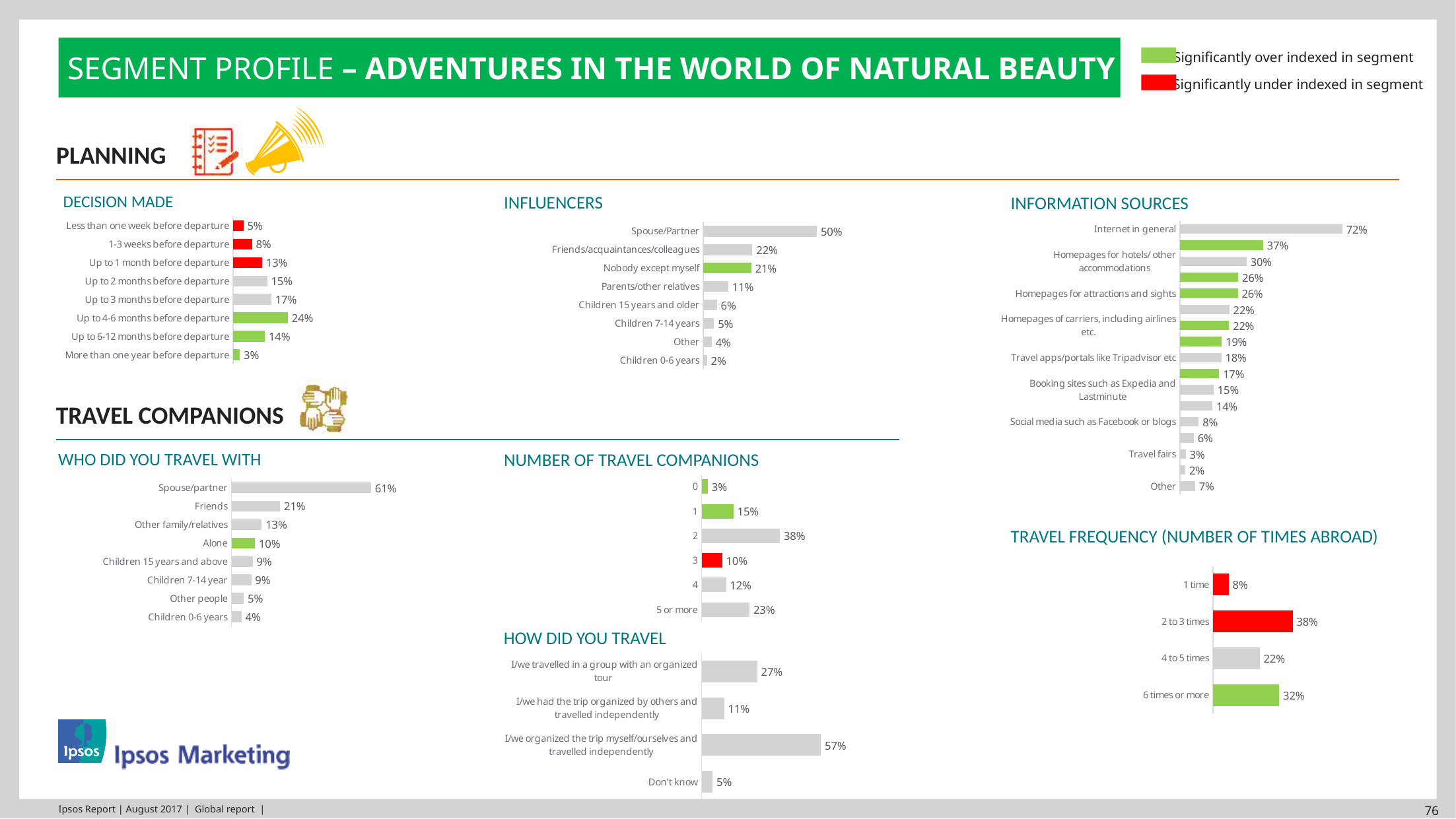
What type of chart is the TRAVEL FREQUENCY (NUMBER OF TIMES ABROAD) chart? Bar chart In the WHO DID YOU TRAVEL WITH chart, how many categories are shown? 8 In the NUMBER OF TRAVEL COMPANIONS chart, which is larger: the value for 4 or the value for 5 or more? 5 or more In the NUMBER OF TRAVEL COMPANIONS chart, what is the value for 2 companions? 38% In the TRAVEL FREQUENCY chart, what is the value for 6 times or more? 32% In the WHO DID YOU TRAVEL WITH chart, which category has the highest value? Spouse/partner In the INFORMATION SOURCES chart, what is the value for Internet in general? 72% In the INFLUENCERS chart, what is the value for Spouse/Partner? 50% In the DECISION MADE chart, what percentage made the decision up to 4-6 months before departure? 24% In the HOW DID YOU TRAVEL chart, what percentage organized the trip themselves and travelled independently? 57% In the DECISION MADE chart, which category has the lowest value? More than one year before departure In the INFLUENCERS chart, what is the difference between Friends/acquaintances/colleagues and Parents/other relatives? 11%